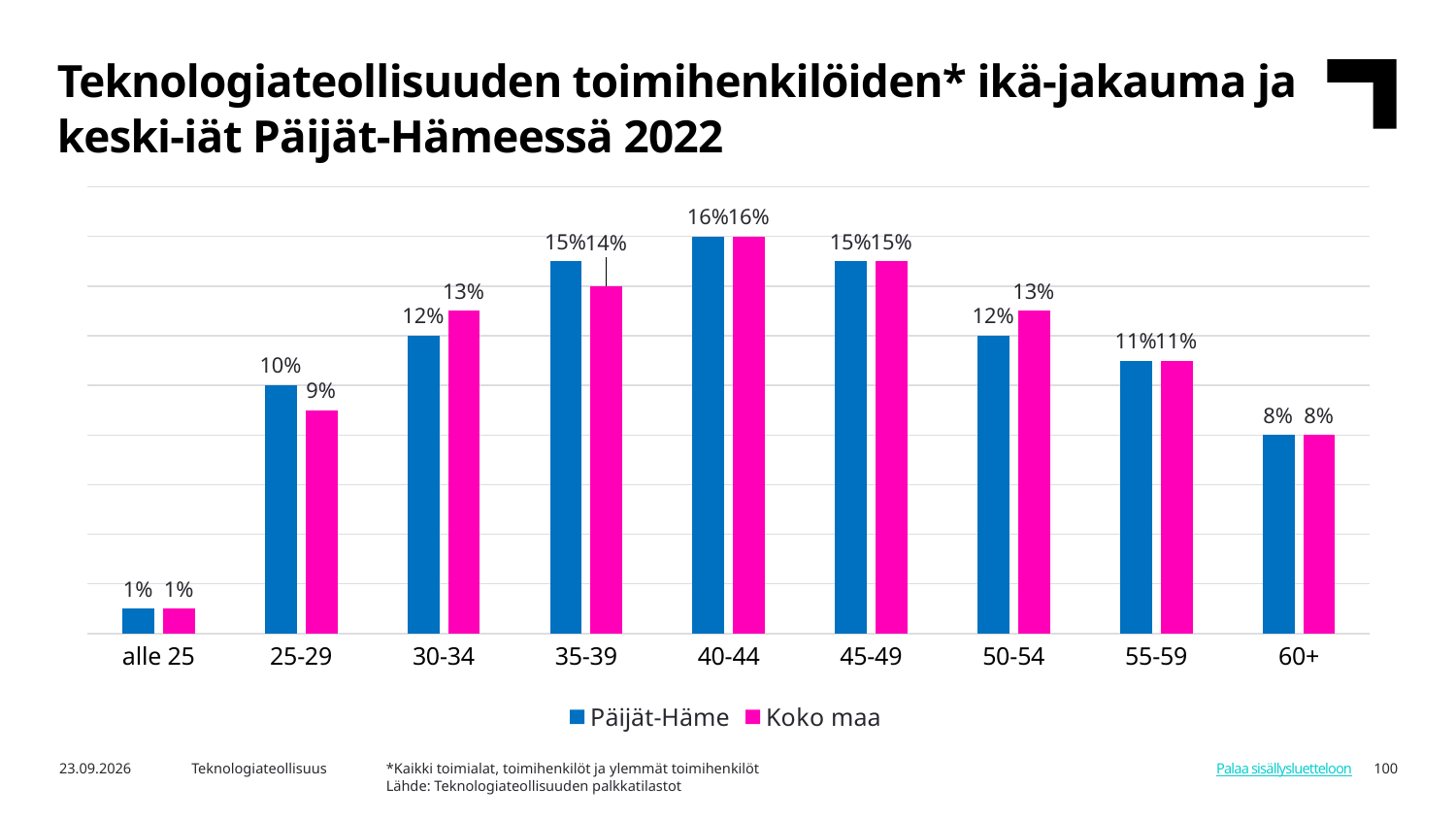
Which age group has the lowest value for Koko maa? alle 25 What is the value for Päijät-Häme in the 25-29 age group? 10% Do the Päijät-Häme values rise or fall from the 40-44 age group to the 60+ age group? Fall How many series does the legend list? 2 In the 50-54 age group, which series has the larger value, Päijät-Häme or Koko maa? Koko maa What is the value for Koko maa in the 30-34 age group? 13% What is the value for Päijät-Häme in the 60+ age group? 8% What kind of chart is shown on the slide? Bar chart Which series is shown in magenta in the legend? Koko maa How many age groups are shown on the x axis? 9 Which age group has the highest value for Päijät-Häme? 40-44 What is the difference between the Päijät-Häme and Koko maa values in the 35-39 age group? 1%